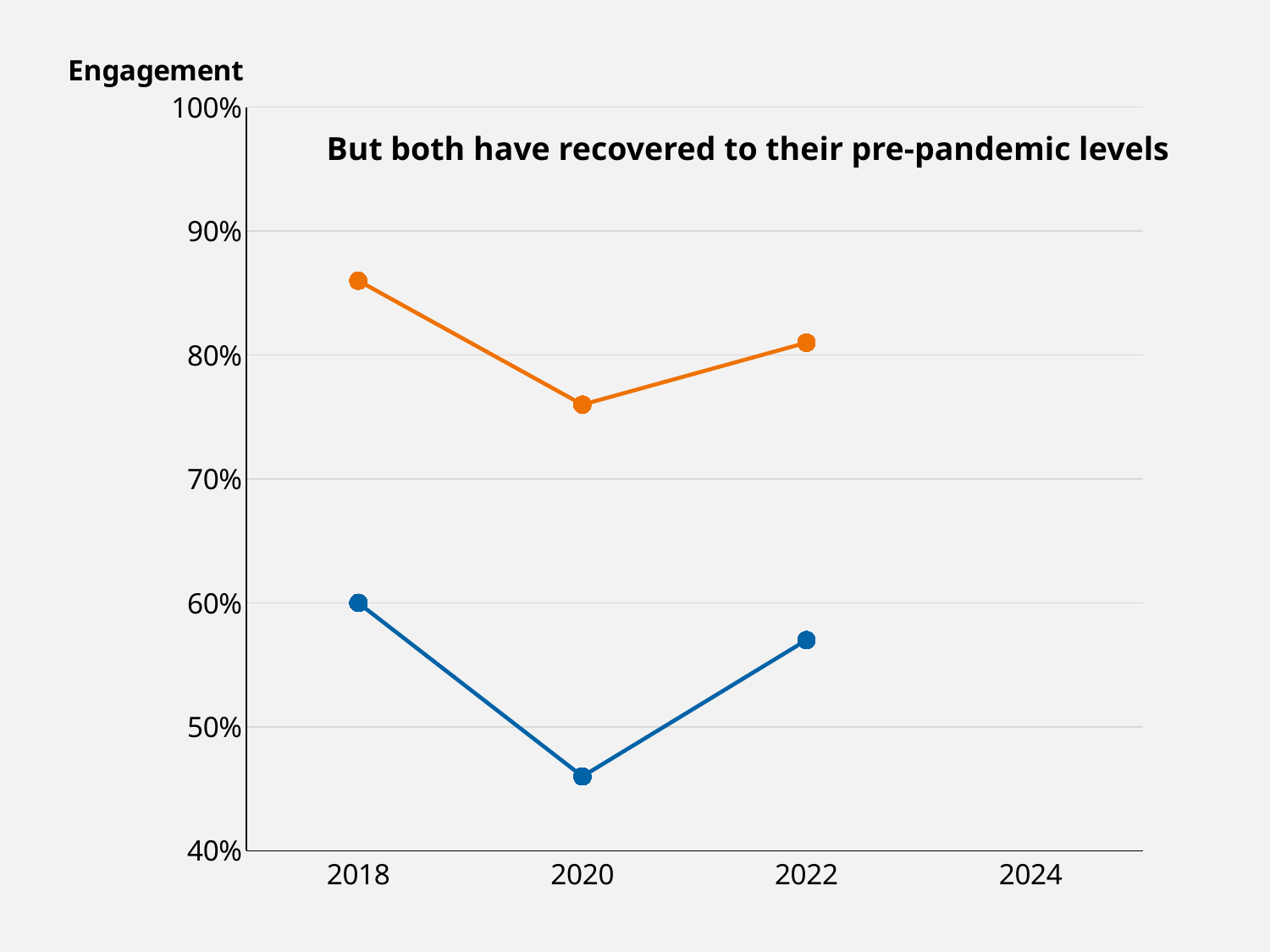
Is the value of the orange line in 2020 greater or less than 80%? less What is the label on the y axis? Engagement What kind of chart is shown on the slide? line chart How many data points are plotted on the orange line? 3 Does the blue line rise or fall from 2020 to 2022? rise In which year is the blue line at its lowest? 2020 Is the value of the blue line in 2020 greater or less than 50%? less Which line has the higher value in 2022, the orange line or the blue line? the orange line In which year is the orange line at its highest? 2018 How many year labels are shown on the x axis? 4 Is the value of the orange line in 2018 greater or less than 80%? greater What is the value of the blue line in 2018? 60%